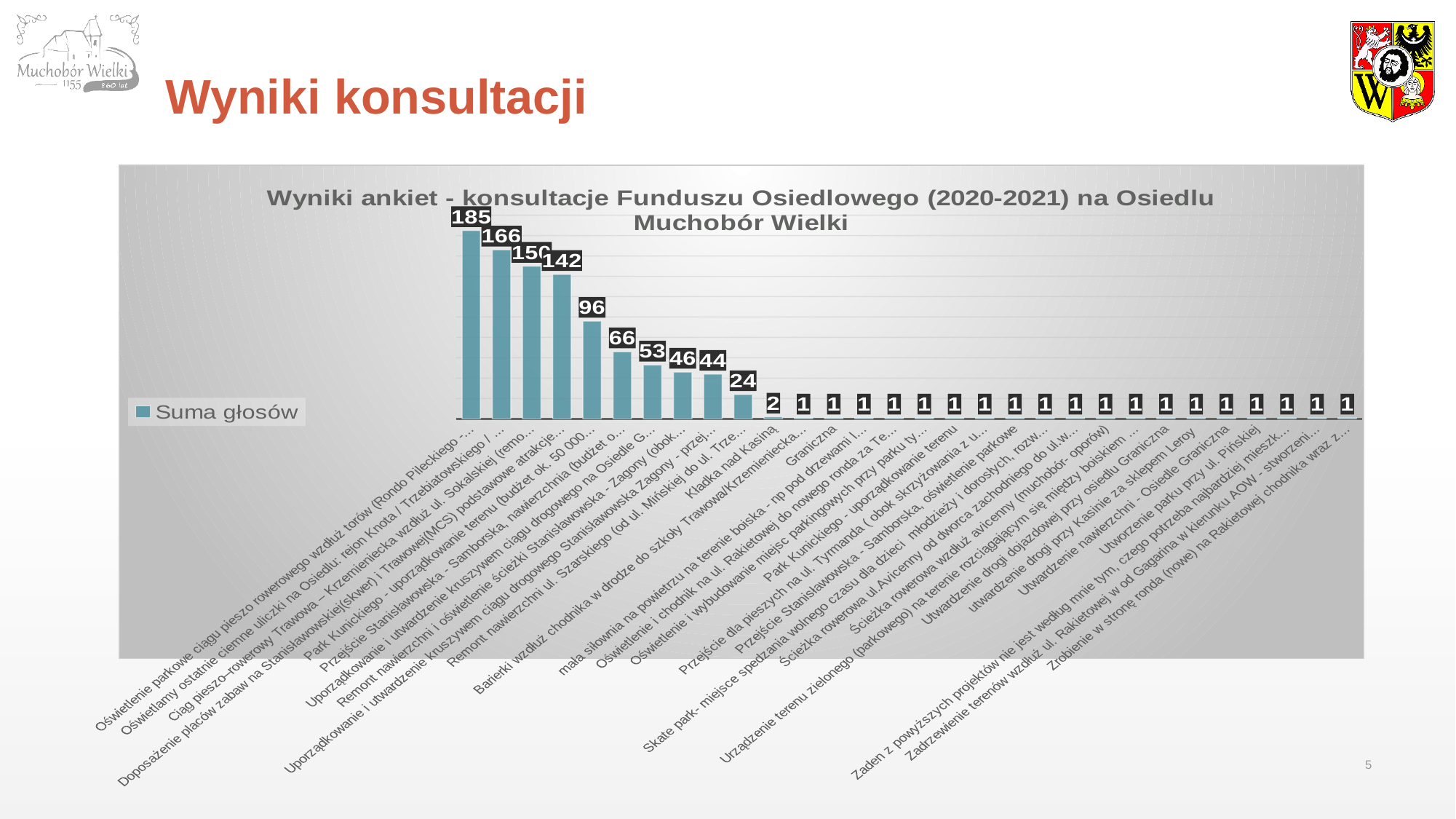
What is the difference between the highest value (185) and the second highest value (166)? 19 How many categories (bars) are shown in the chart? 30 What type of chart is shown on the slide? bar chart What is the title of the chart? Wyniki ankiet - konsultacje Funduszu Osiedlowego (2020-2021) na Osiedlu Muchobór Wielki How many series does the legend list? 1 Do the values rise or fall from left to right along the x axis? fall What is the highest value shown in the chart? 185 What is the name of the series shown in the legend? Suma głosów What is the value for 'Kładka nad Kasiną'? 2 What is the value for 'Graniczna'? 1 What is the difference between the values 96 and 66 shown on the chart? 30 What is the value for 'Utworzenie parku przy ul. Pińskiej'? 1